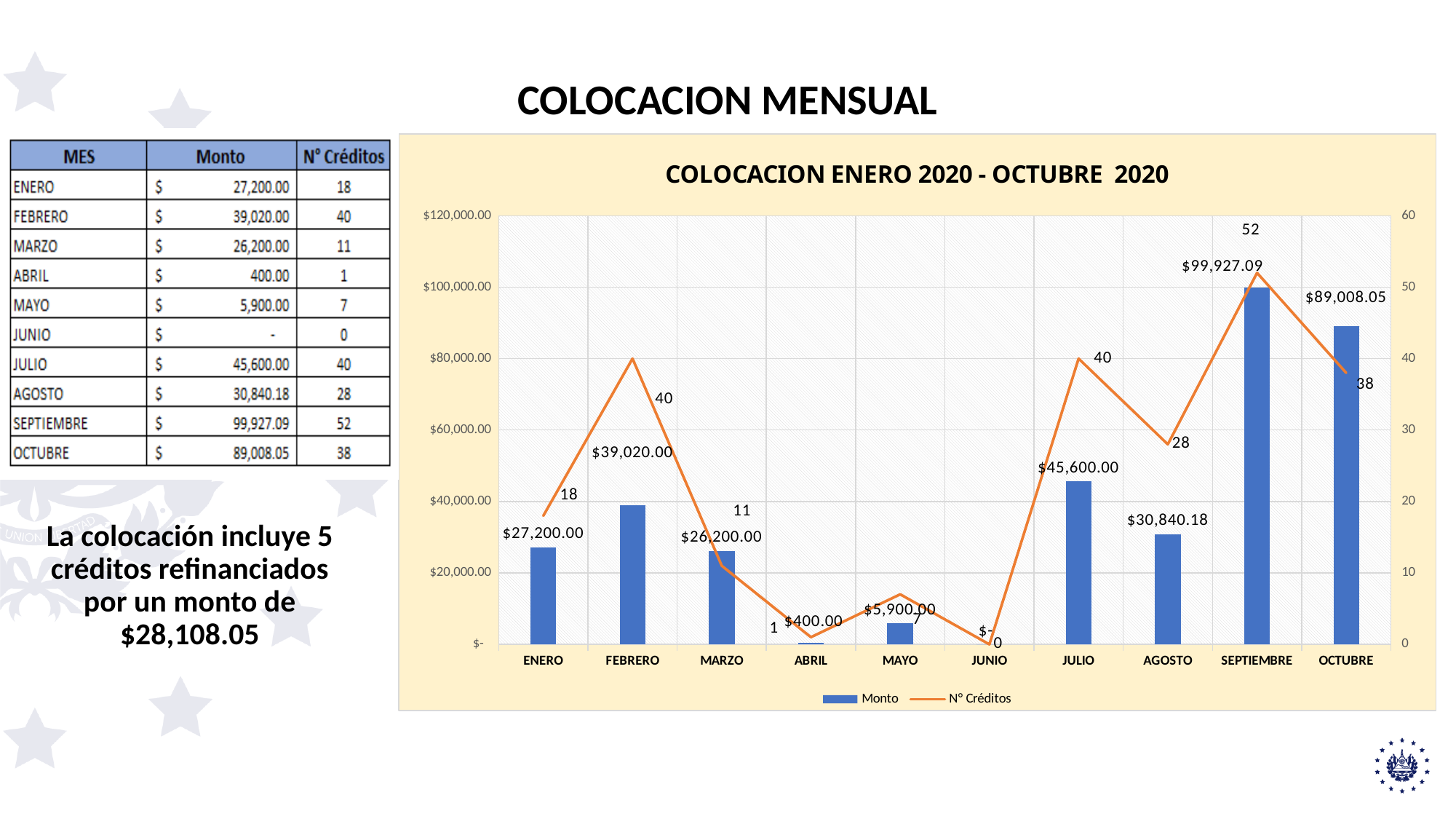
Which month has the lowest N° Créditos? JUNIO What is the Monto value for SEPTIEMBRE? $99,927.09 Which is larger, the Monto for JULIO or the Monto for FEBRERO? JULIO How many months are shown on the x axis of the chart? 10 What is the N° Créditos value for FEBRERO? 40 What is the difference in Monto between SEPTIEMBRE and OCTUBRE? $10,919.04 What is the title of the chart? COLOCACION ENERO 2020 - OCTUBRE 2020 What kind of chart is used to show the Monto series? Bar chart How many series does the chart legend list? 2 What is the Monto value for AGOSTO? $30,840.18 Which month has the highest Monto? SEPTIEMBRE What is the difference in N° Créditos between SEPTIEMBRE and AGOSTO? 24